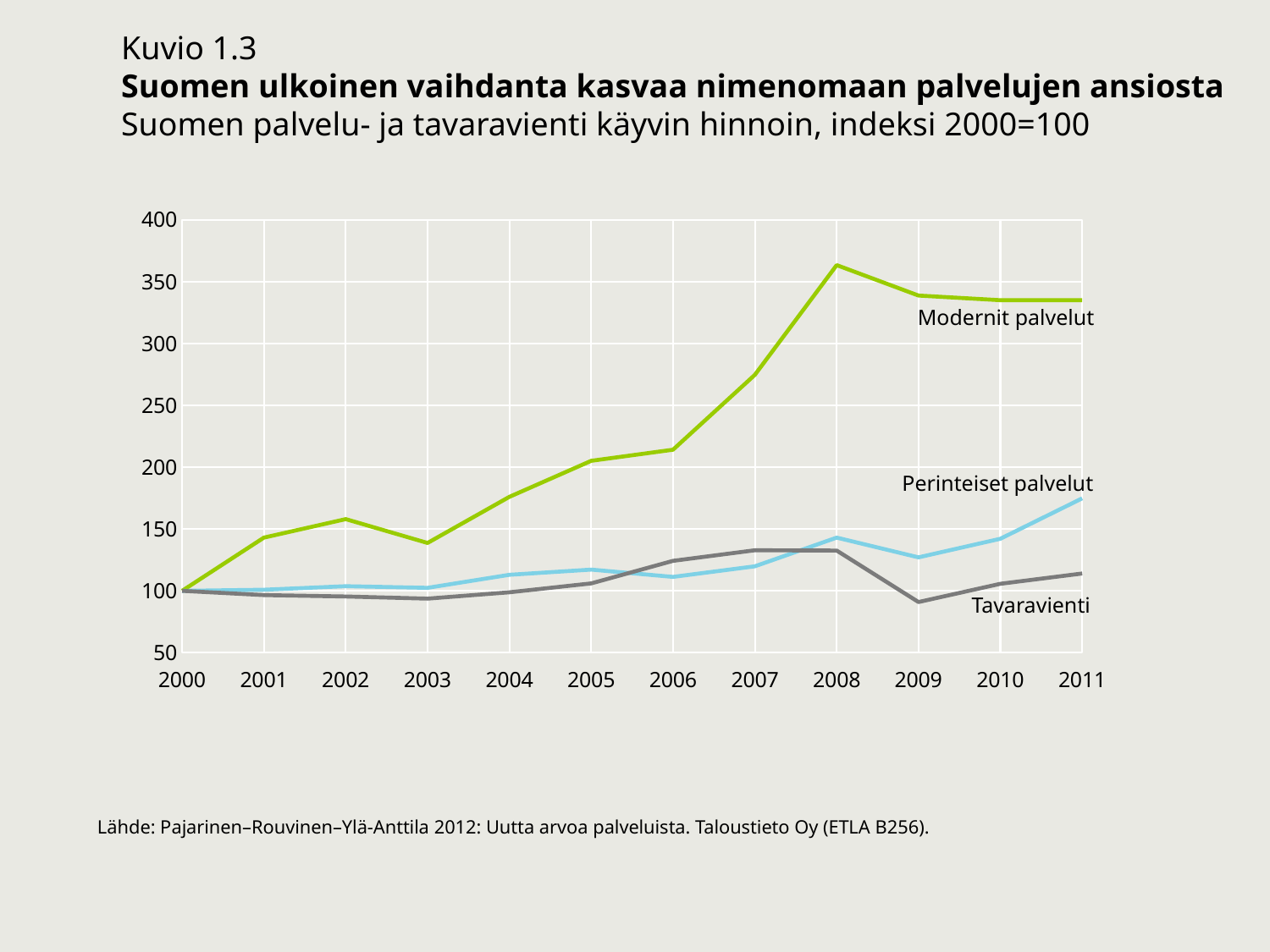
In 2009, which is larger: Perinteiset palvelut or Tavaravienti? Perinteiset palvelut How many series are plotted in the chart? 3 In which year does Modernit palvelut reach its highest value? 2008 What kind of chart is shown on the slide? line chart Is the value for Perinteiset palvelut in 2011 greater or less than 150? greater How many years are shown along the x axis of the chart? 12 Is the value for Modernit palvelut in 2008 greater or less than 350? greater Which series has the highest value in 2011? Modernit palvelut Is the value for Tavaravienti in 2009 greater or less than 100? less Which series has the lowest value in 2011? Tavaravienti Does the Modernit palvelut line rise or fall between 2000 and 2008? rise What is the index value of Modernit palvelut in 2000? 100